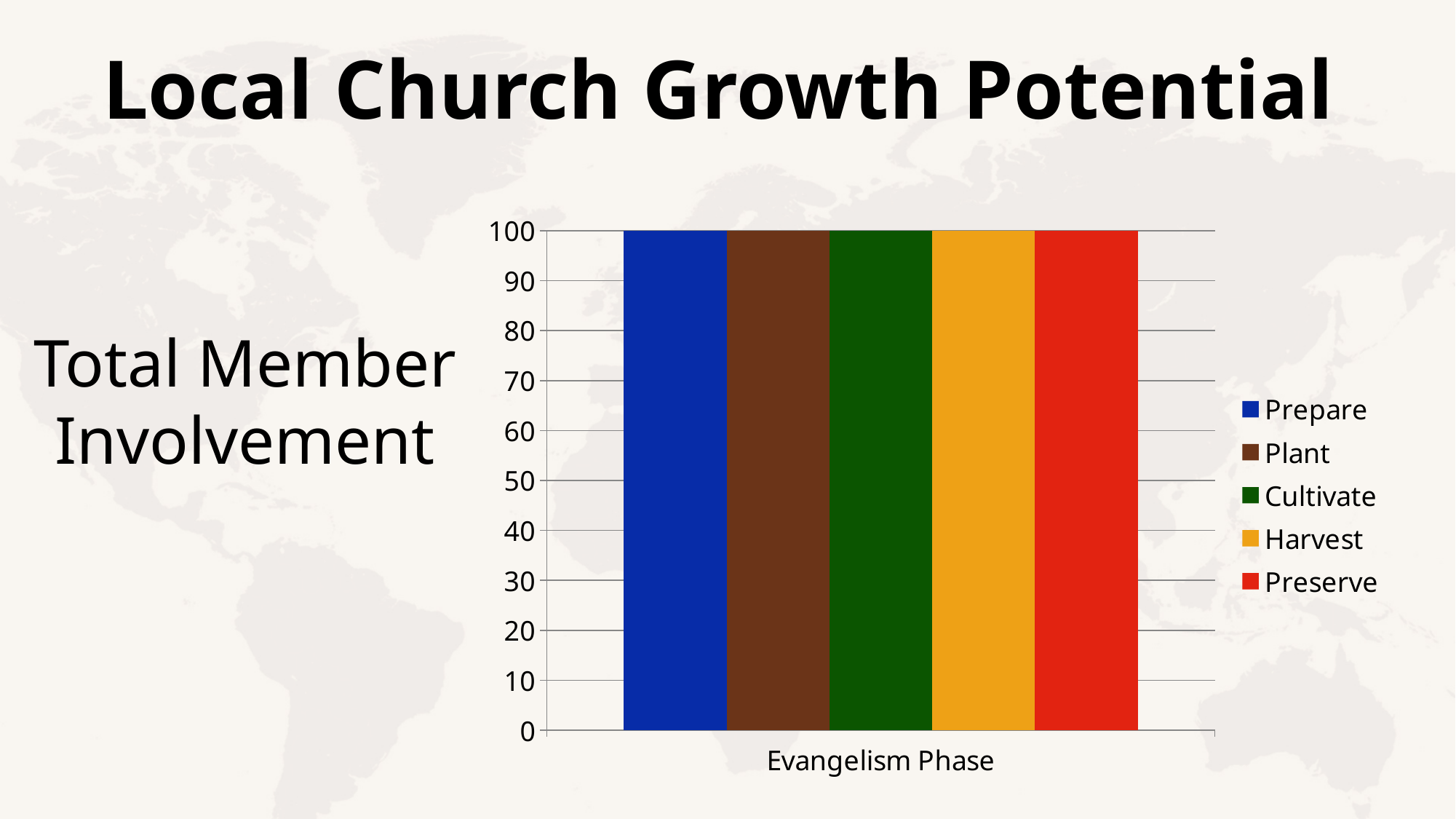
What is the value for Preserve? 100 What is the value for Prepare? 100 What is the value for Harvest? 100 How many categories are shown on the x axis? 1 Is the value for Harvest greater or less than 50? greater What is the value for Plant? 100 Which series is shown in green? Cultivate What kind of chart is shown on the slide? bar chart What is the difference between the values for Prepare and Preserve? 0 What is the value for Cultivate? 100 What is the label on the x axis? Evangelism Phase How many series does the legend list? 5